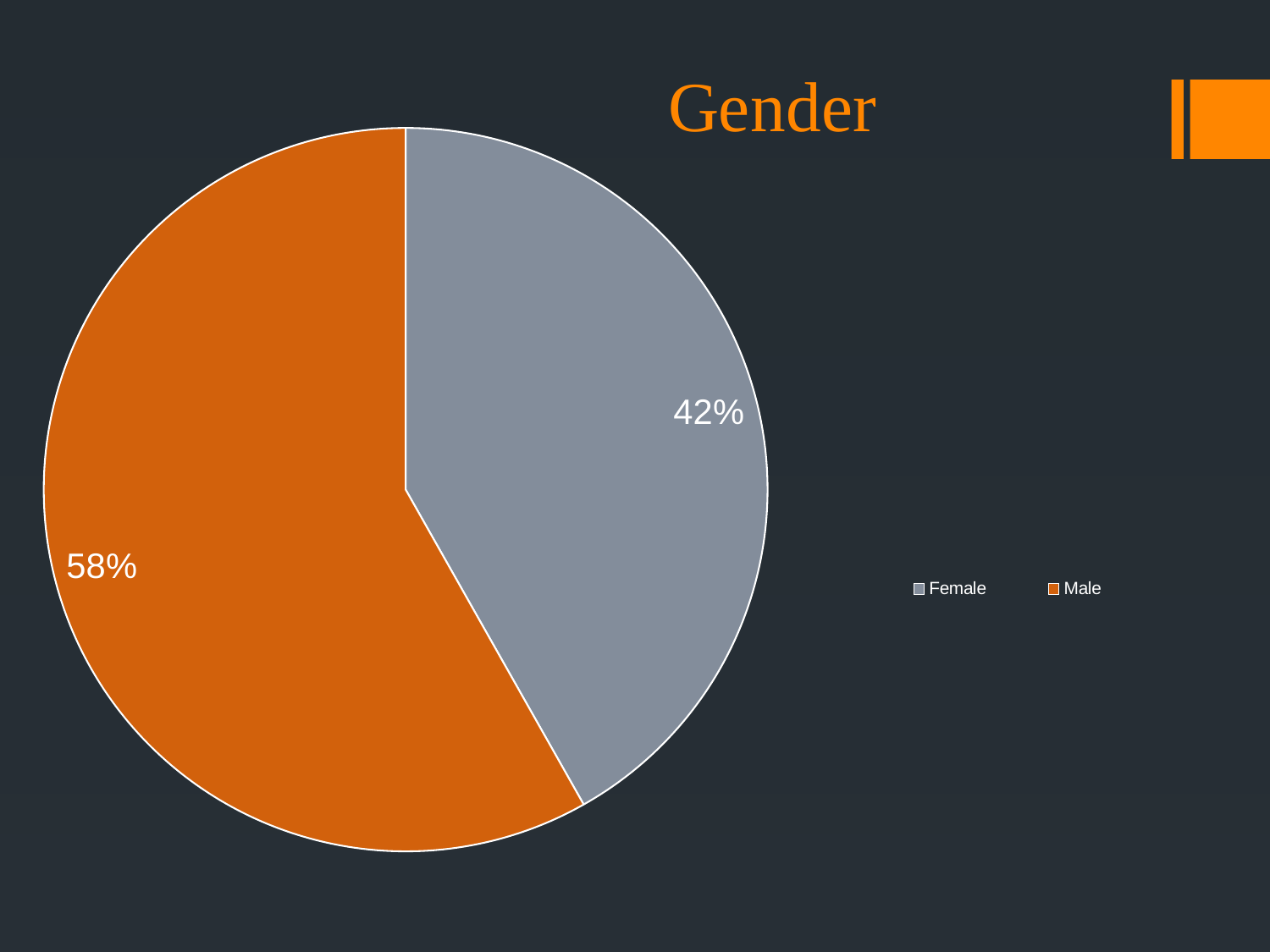
How many categories does the pie chart show? 2 What kind of chart is shown on the slide? pie chart What percentage of the pie is Female? 42% What colour is the Male slice? orange How many entries does the legend list? 2 Which category has the largest share of the pie? Male What percentage of the pie is Male? 58% Is the Female share greater or less than 50%? less Which category has the smallest share of the pie? Female What is the title of the chart? Gender What is the difference in percentage points between the Male and Female slices? 16 Which slice is larger, Female or Male? Male